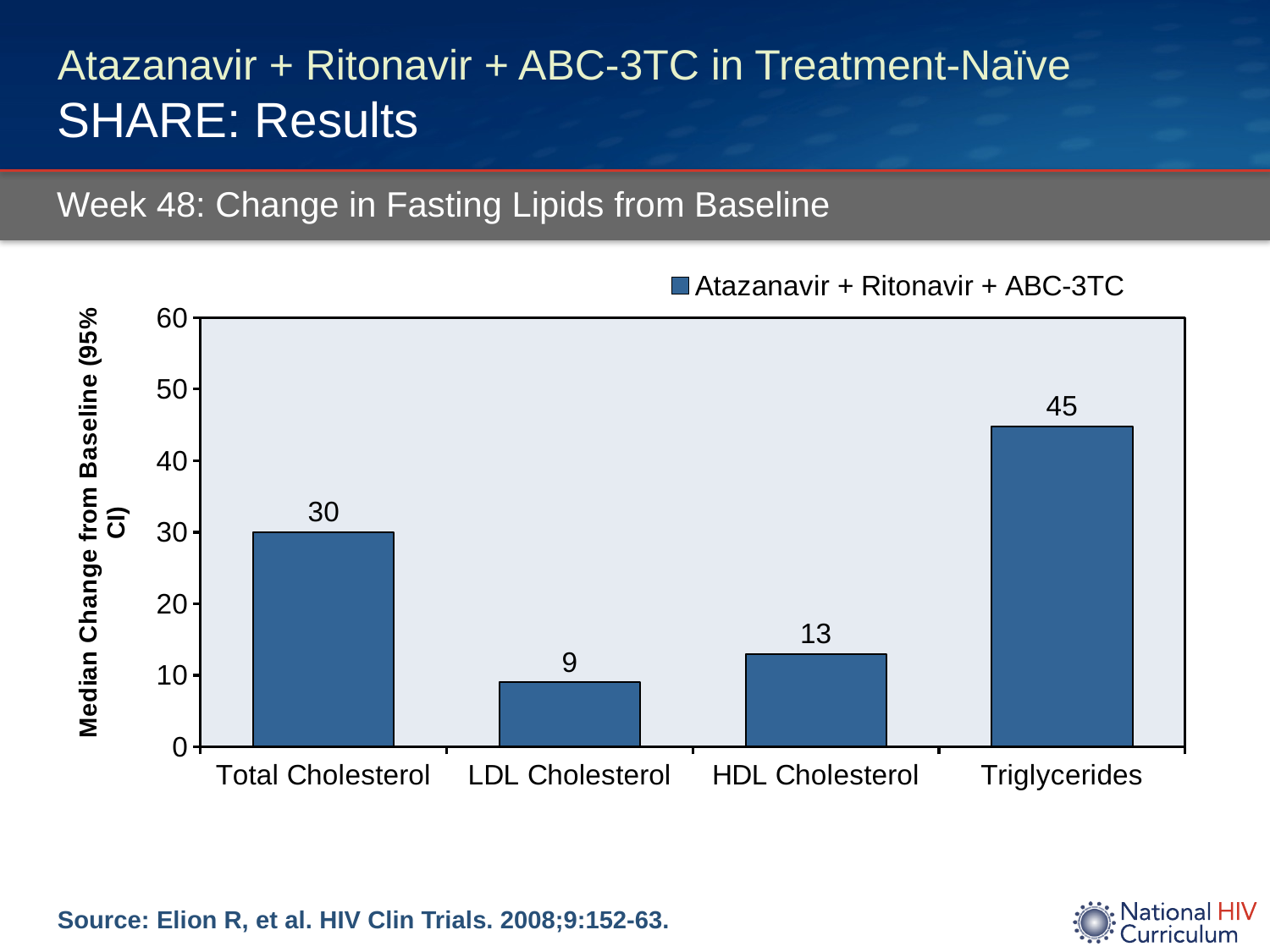
How many categories are shown on the x axis? 4 What kind of chart is shown on the slide? Bar chart What is the median change from baseline for Total Cholesterol? 30 Which category has the lowest median change from baseline? LDL Cholesterol What is the difference between the values for Triglycerides and Total Cholesterol? 15 What is the median change from baseline for LDL Cholesterol? 9 Which is larger, the value for Total Cholesterol or the value for HDL Cholesterol? Total Cholesterol Which category has the highest median change from baseline? Triglycerides What series does the legend list? Atazanavir + Ritonavir + ABC-3TC What is the median change from baseline for HDL Cholesterol? 13 What is the median change from baseline for Triglycerides? 45 What is the difference between the values for HDL Cholesterol and LDL Cholesterol? 4